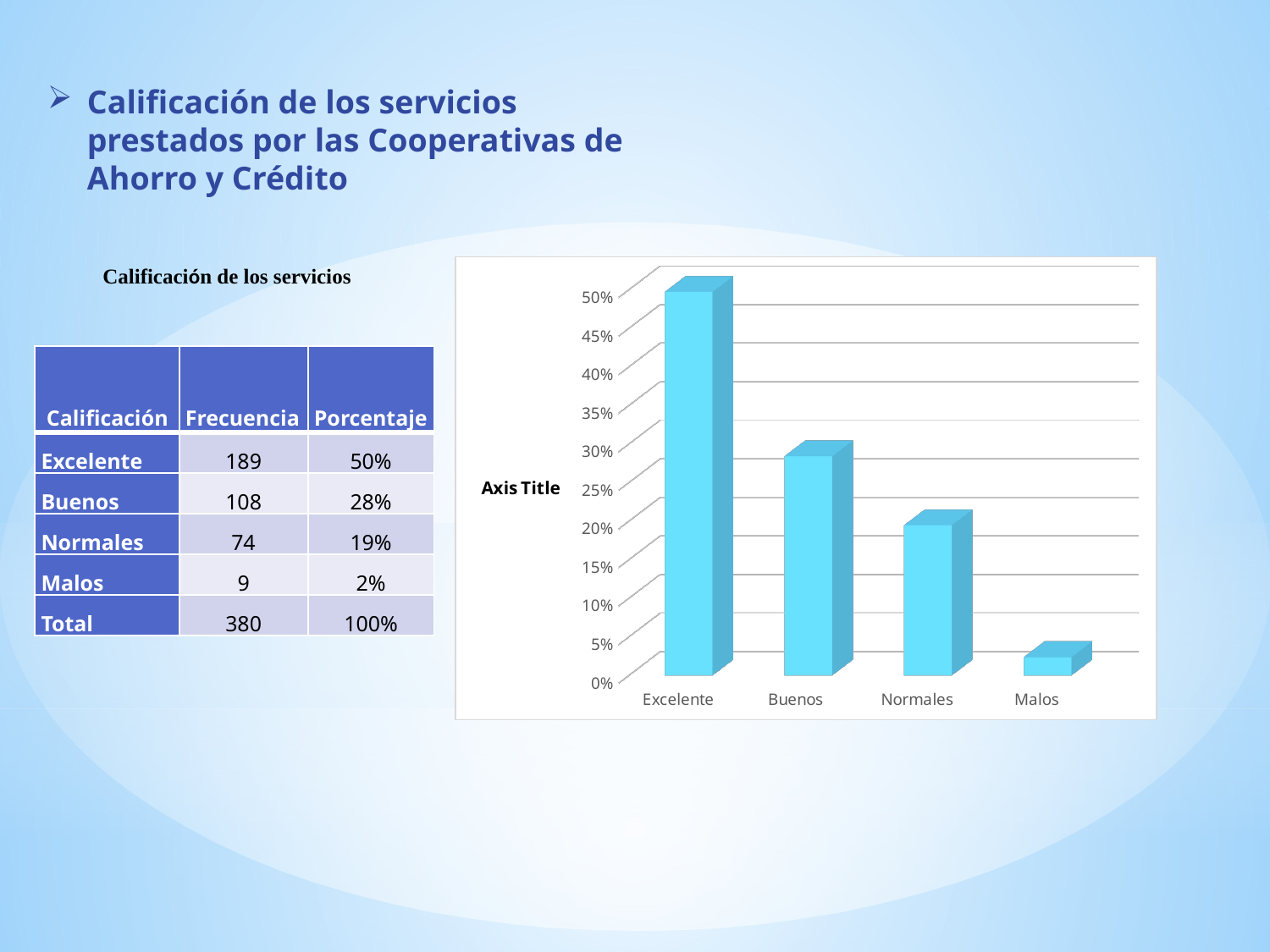
Which category has the lowest bar in the chart? Malos Is the value for Malos greater or less than 5%? less Do the bar values rise or fall from Excelente to Malos along the x axis? Fall Which is larger, the bar for Buenos or the bar for Normales? Buenos Is the value for Buenos greater or less than 25%? greater What text is shown as the vertical axis title of the chart? Axis Title What kind of chart is shown on the slide? Bar chart Which category has the highest bar in the chart? Excelente What is the value for Excelente in the bar chart? 50% How many categories are shown on the x axis of the chart? 4 Is the value for Buenos greater or less than 30%? less